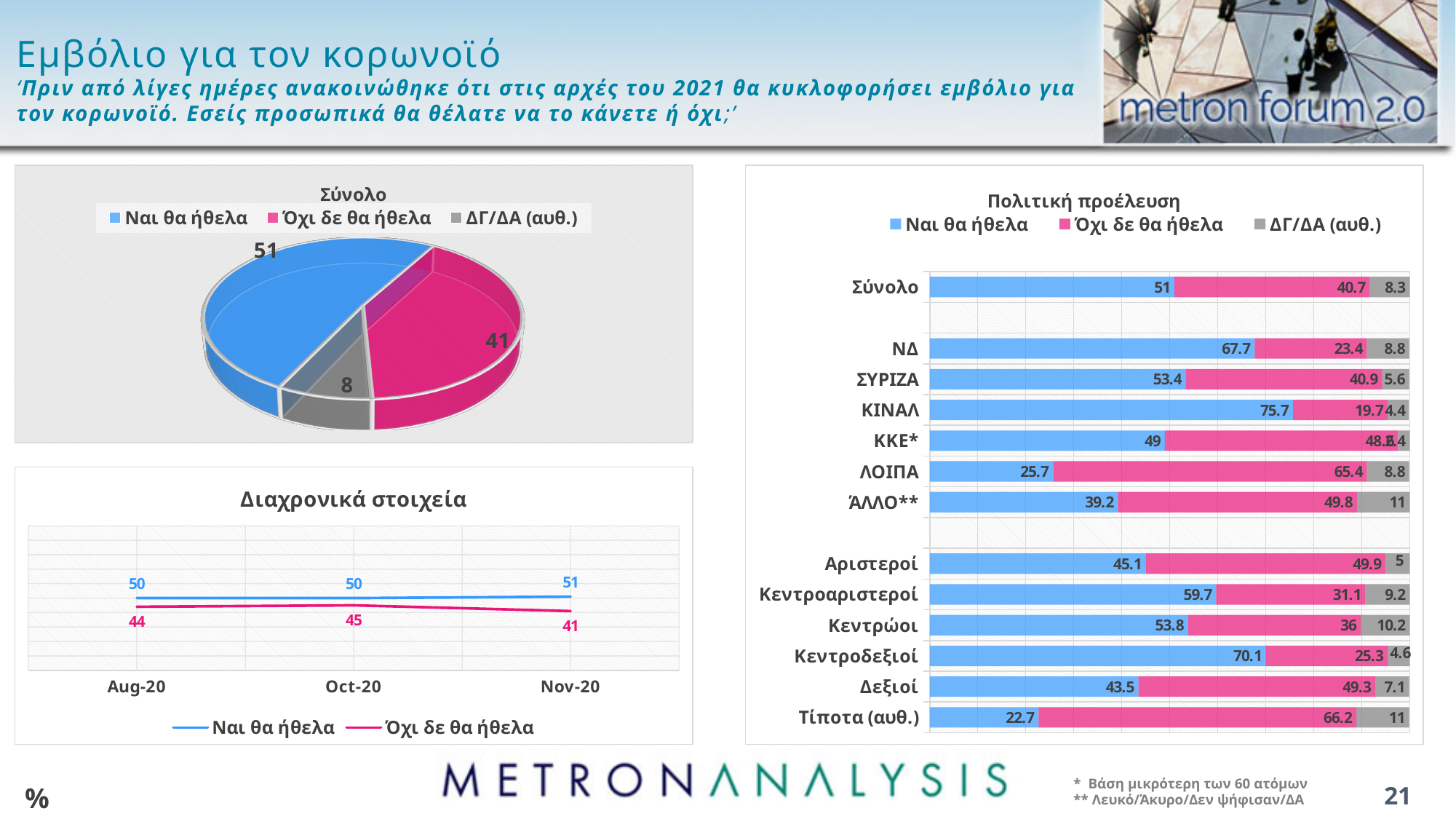
In the pie chart titled Σύνολο, what is the value for Ναι θα ήθελα? 51 In the bar chart titled Πολιτική προέλευση, which category has the lowest value for Ναι θα ήθελα? Τίποτα (αυθ.) In the bar chart titled Πολιτική προέλευση, what is the value of Όχι δε θα ήθελα for ΛΟΙΠΑ? 65.4 In the line chart titled Διαχρονικά στοιχεία, what is the difference between Ναι θα ήθελα and Όχι δε θα ήθελα at Nov-20? 10 In the line chart titled Διαχρονικά στοιχεία, what is the value for Όχι δε θα ήθελα at Oct-20? 45 In the bar chart titled Πολιτική προέλευση, what is the value of Ναι θα ήθελα for ΝΔ? 67.7 In the bar chart titled Πολιτική προέλευση, which has the larger value for Ναι θα ήθελα, Κεντροδεξιοί or Δεξιοί? Κεντροδεξιοί In the bar chart titled Πολιτική προέλευση, which category has the highest value for Ναι θα ήθελα? ΚΙΝΑΛ How many series does the legend of the bar chart titled Πολιτική προέλευση list? 3 What kind of chart is the one titled Σύνολο? pie chart In the bar chart titled Πολιτική προέλευση, what is the total of the stacked bar for Κεντρώοι? 100 How many time points are shown on the x axis of the line chart titled Διαχρονικά στοιχεία? 3